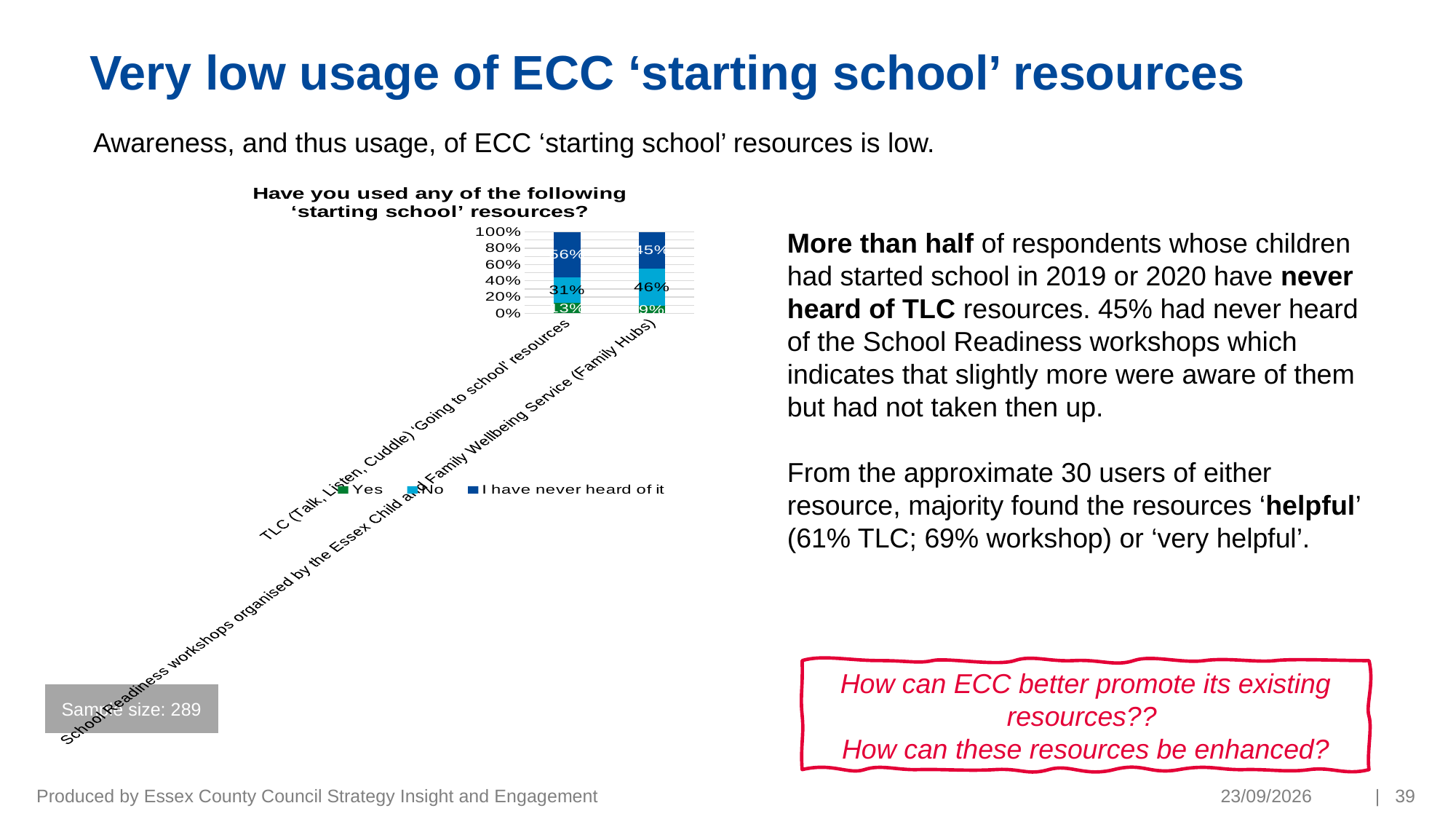
What percentage of respondents had never heard of the TLC (Talk, Listen, Cuddle) 'Going to school' resources? 56% How many categories (resources) are shown on the x axis of the chart? 2 Which resource has the higher share of respondents who have never heard of it? TLC (Talk, Listen, Cuddle) 'Going to school' resources What is the title of the chart? Have you used any of the following 'starting school' resources? What percentage of respondents answered 'No' for the TLC (Talk, Listen, Cuddle) 'Going to school' resources? 31% What kind of chart is shown on the slide? Stacked bar chart Is the 'Yes' share for the TLC (Talk, Listen, Cuddle) 'Going to school' resources greater or less than 20%? less How many series does the chart legend list? 3 What percentage of respondents had never heard of the School Readiness workshops? 45% What percentage of respondents answered 'No' for the School Readiness workshops? 46% What is the difference between the 'I have never heard of it' share for TLC resources (56%) and for the School Readiness workshops (45%)? 11% Which resource has the higher share of 'No' responses? School Readiness workshops organised by the Essex Child and Family Wellbeing Service (Family Hubs)